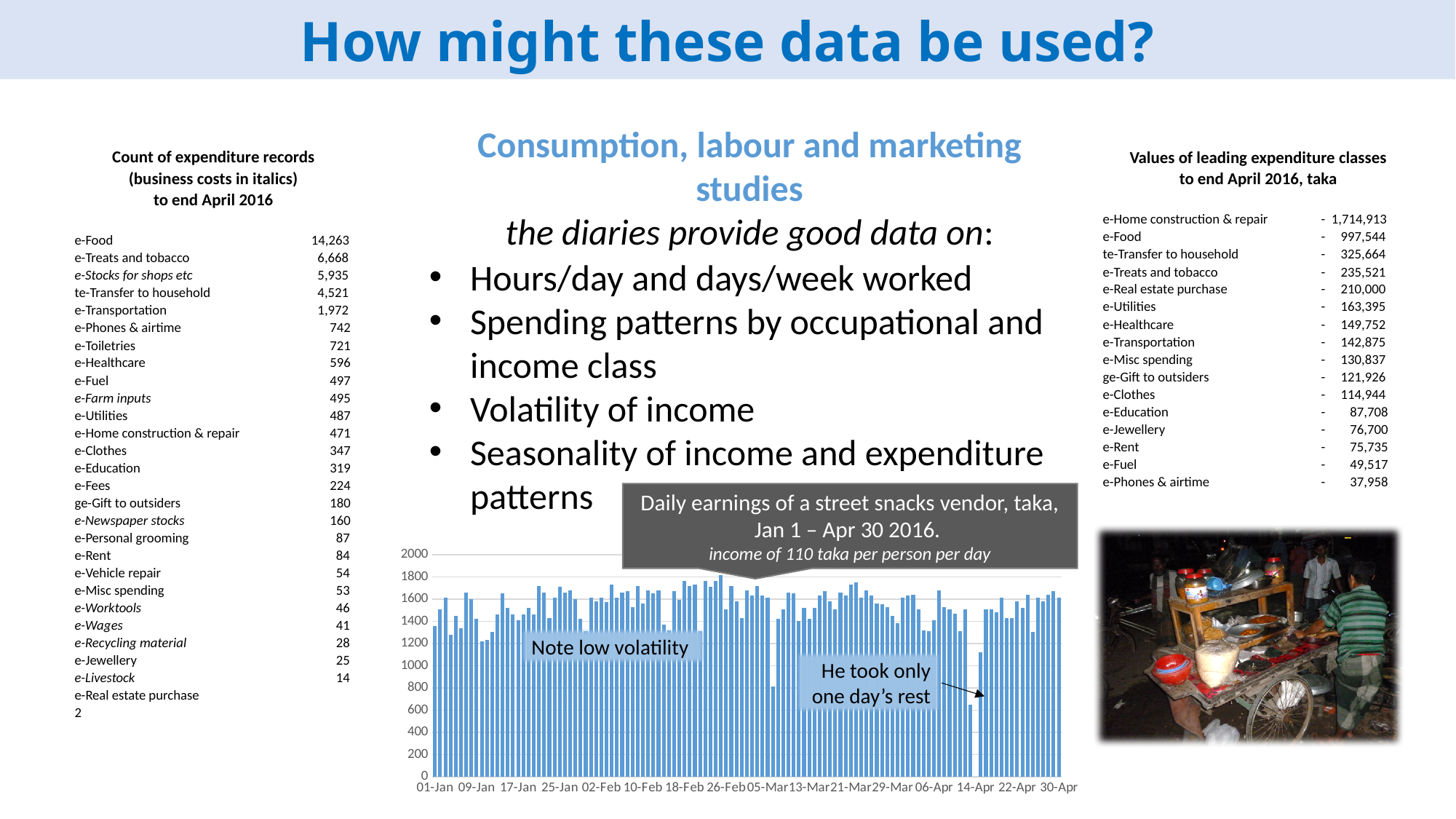
In the daily earnings chart, is the lowest bar (the day's rest near 14-Apr) greater or less than 800? less In the daily earnings chart, is the value for 30-Apr greater or less than 1200? greater How many date labels are shown along the x axis of the daily earnings chart? 16 What kind of chart is shown at the bottom centre of the slide? bar chart In the daily earnings chart, near which x-axis date label does the lowest bar occur? 14-Apr In the daily earnings chart, is the value for 01-Jan greater or less than 1600? less What is the highest tick value shown on the y axis of the daily earnings chart? 2000 What is the title of the chart at the bottom centre of the slide? Daily earnings of a street snacks vendor, taka, Jan 1 – Apr 30 2016. Across the daily earnings chart, do the values show a strong rising or falling trend, or stay roughly flat? roughly flat